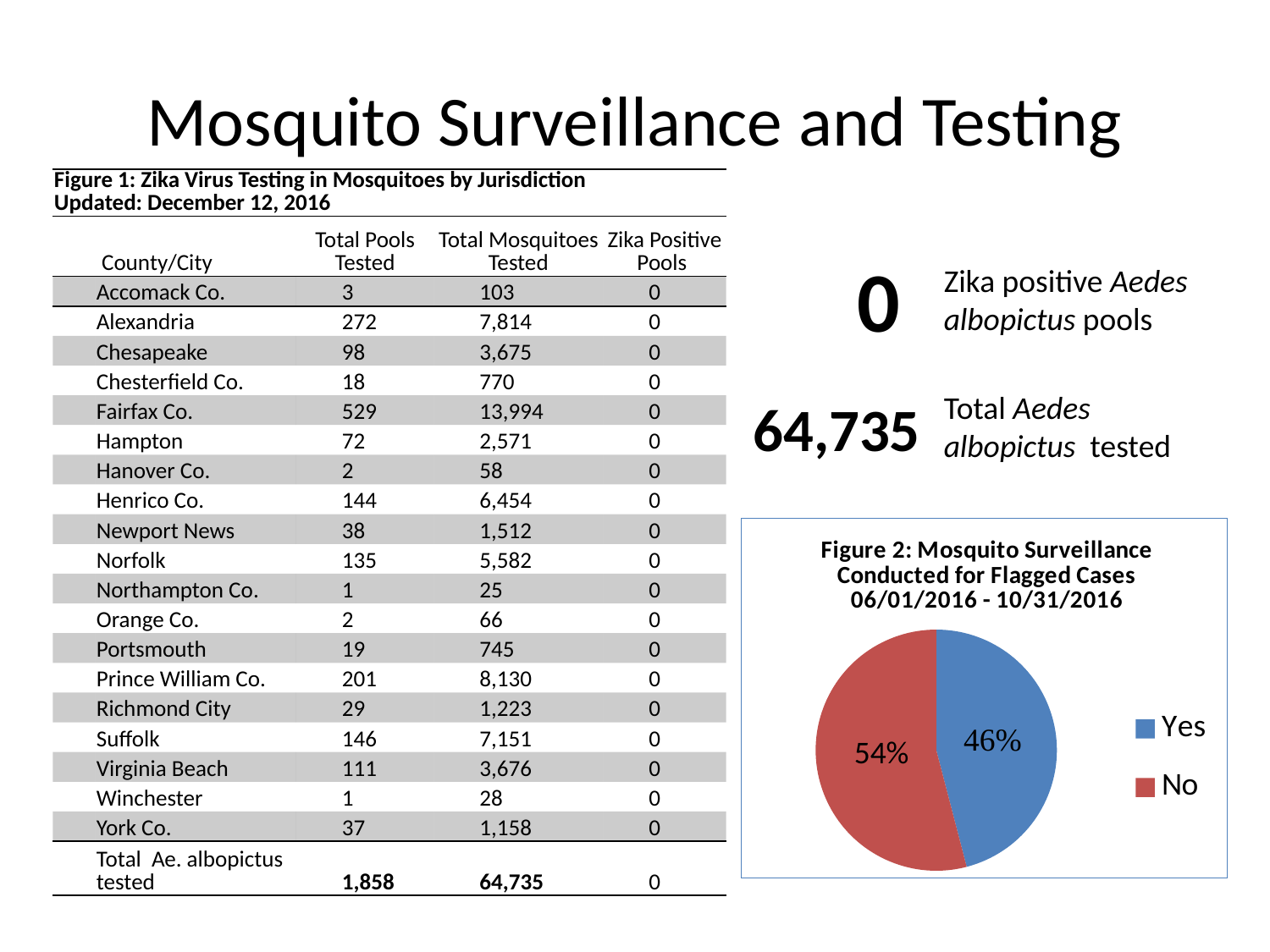
How many entries does the legend of the pie chart list? 2 What colour is the Yes slice in the pie chart? blue Which category has the smallest slice in the pie chart? Yes In the pie chart, what share of flagged cases had mosquito surveillance conducted (Yes)? 46% Which slice of the pie chart is larger, Yes or No? No In the pie chart, what share of flagged cases did not have mosquito surveillance conducted (No)? 54% What date range is given in the title of the pie chart? 06/01/2016 - 10/31/2016 What type of chart is Figure 2: Mosquito Surveillance Conducted for Flagged Cases? pie chart Which category has the largest slice in the pie chart? No What is the difference in percentage points between the No and Yes slices of the pie chart? 8 How many slices does the pie chart have? 2